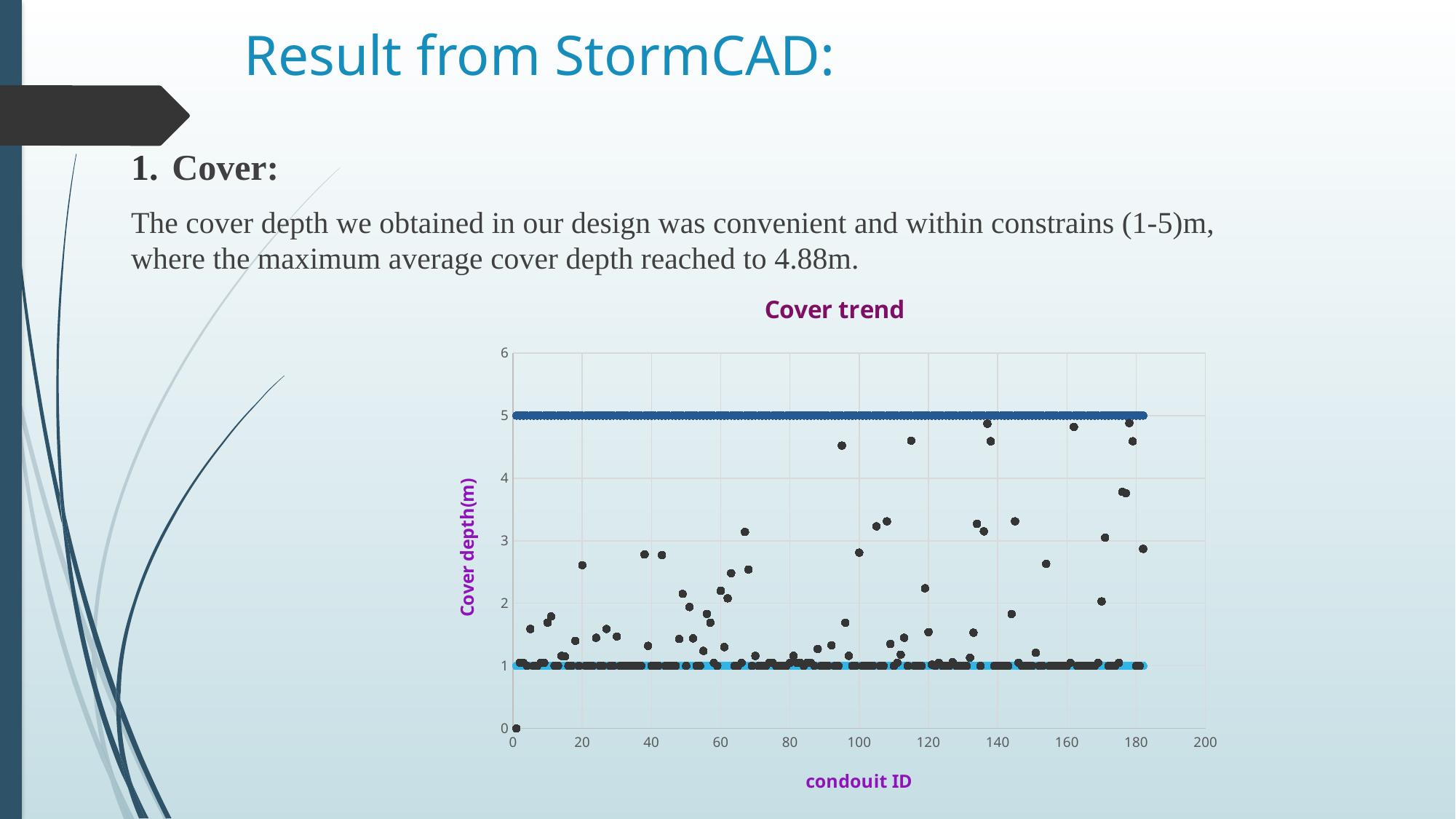
What is the label of the vertical axis of the chart? Cover depth(m) What is the title of the chart? Cover trend What is the difference in cover depth between the upper dark blue line and the lower light blue line? 4 Is the black data point near conduit ID 20 greater or less than 2? greater Is the highest black data point greater or less than 5? less What is the lowest cover depth value plotted among the black points? 0 What kind of chart is shown on the slide? scatter chart Is the black data point near conduit ID 95 greater or less than 4? greater Which is higher, the dark blue horizontal line or the light blue horizontal line? the dark blue line At what cover depth is the upper dark blue horizontal line drawn? 5 At what cover depth is the lower light blue horizontal line drawn? 1